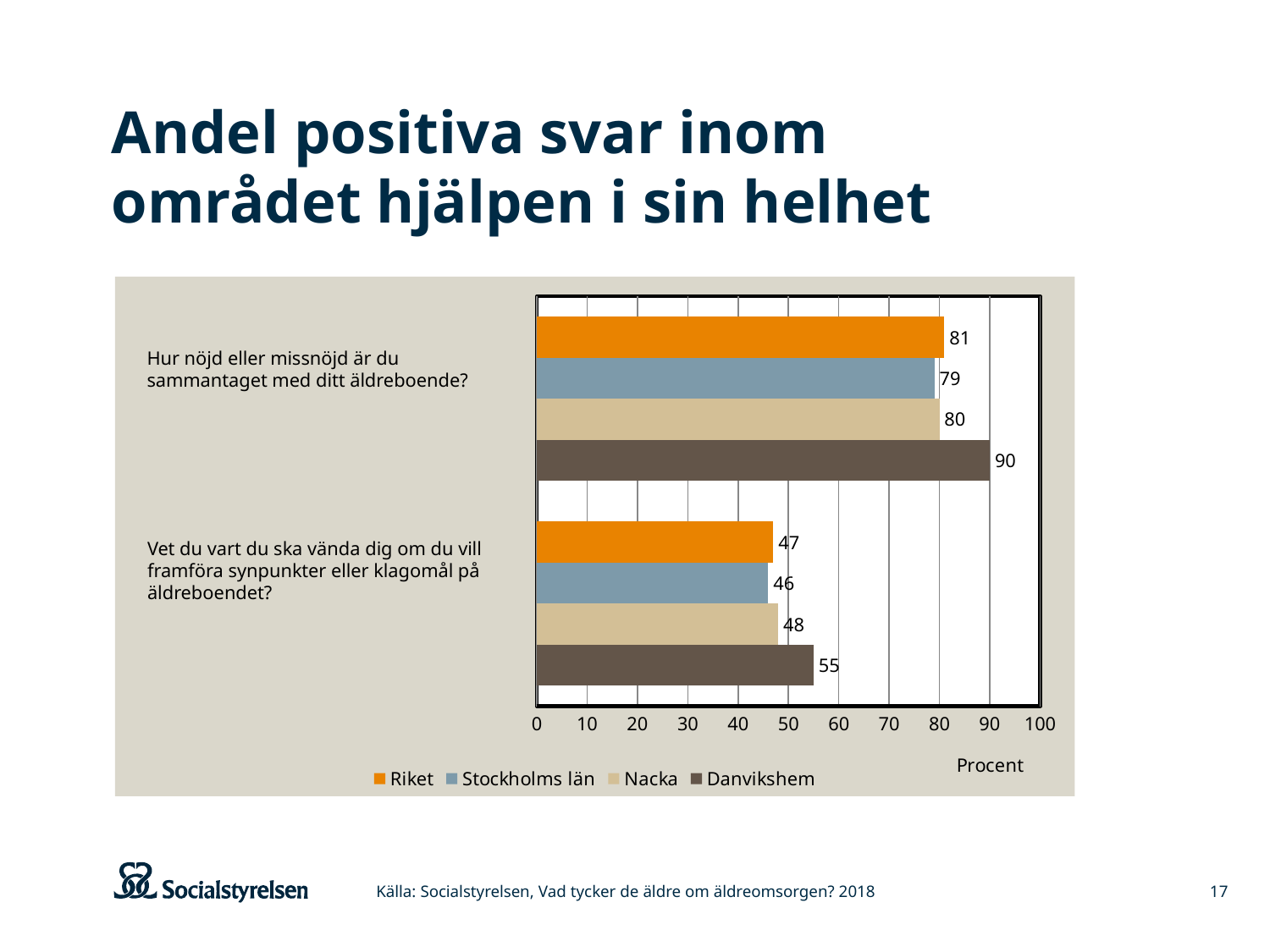
What is the value for Stockholms län on the question "Hur nöjd eller missnöjd är du sammantaget med ditt äldreboende?"? 79 Which series has the highest value on the question "Vet du vart du ska vända dig om du vill framföra synpunkter eller klagomål på äldreboendet?"? Danvikshem What is the value for Nacka on the question "Vet du vart du ska vända dig om du vill framföra synpunkter eller klagomål på äldreboendet?"? 48 What is the value for Riket on the question "Vet du vart du ska vända dig om du vill framföra synpunkter eller klagomål på äldreboendet?"? 47 What is the difference between Danvikshem and Riket on the question "Hur nöjd eller missnöjd är du sammantaget med ditt äldreboende?"? 9 How many series does the legend list? 4 What kind of chart is shown on the slide? Bar chart Is the value for Danvikshem higher on the question about overall satisfaction ("Hur nöjd eller missnöjd...") or on the question about knowing where to turn with complaints ("Vet du vart du ska vända dig...")? Hur nöjd eller missnöjd är du sammantaget med ditt äldreboende? Which series has the lowest value on the question "Hur nöjd eller missnöjd är du sammantaget med ditt äldreboende?"? Stockholms län What is the difference between Danvikshem and Stockholms län on the question "Vet du vart du ska vända dig om du vill framföra synpunkter eller klagomål på äldreboendet?"? 9 What is the value for Danvikshem on the question "Hur nöjd eller missnöjd är du sammantaget med ditt äldreboende?"? 90 What is the label of the horizontal axis? Procent